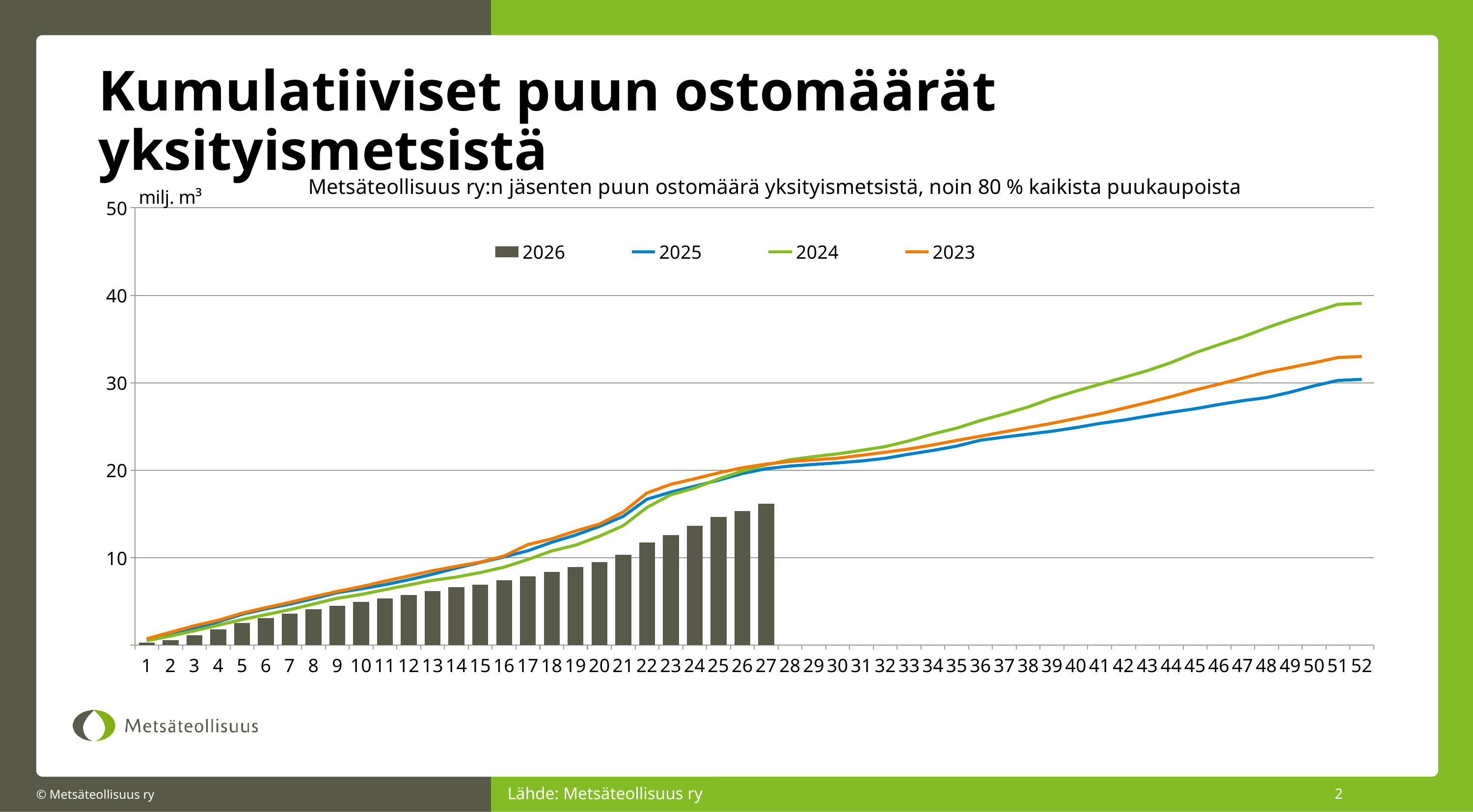
How many bars are plotted for the 2026 series? 27 Do the values rise or fall along the x axis? rise Which series is drawn as bars? 2026 Is the value for 2024 at week 52 greater or less than 35? greater Is the 2026 bar at week 27 greater or less than 20? less How many weeks are shown on the x axis? 52 Which series has the lowest value at week 52? 2025 How many series does the legend list? 4 What kind of chart is this? Combined bar and line chart At week 52, which is larger: the value for 2024 or the value for 2023? 2024 Is the value for 2025 at week 52 greater or less than 35? less Which series has the highest value at week 52? 2024